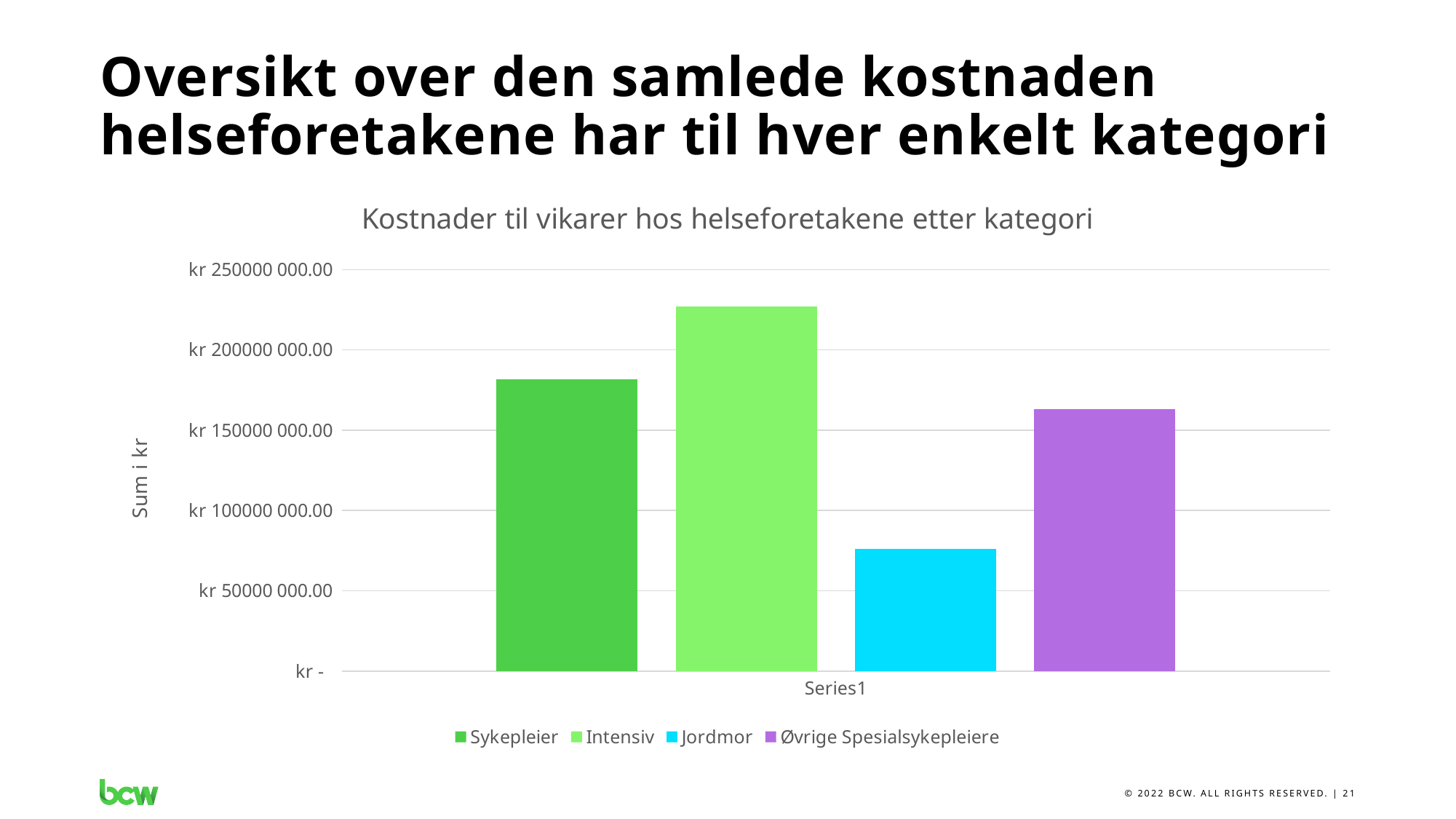
Which is larger, the value for Jordmor or the value for Intensiv? Intensiv What kind of chart is shown on the slide? Bar chart What is the label of the vertical axis? Sum i kr What is the title of the chart? Kostnader til vikarer hos helseforetakene etter kategori Which category has the lowest cost? Jordmor Is the value for Intensiv greater or less than kr 200000 000.00? greater Is the value for Jordmor greater or less than kr 100000 000.00? less Which category has the highest cost? Intensiv Is the value for Sykepleier greater or less than kr 150000 000.00? greater Which is larger, the value for Sykepleier or the value for Øvrige Spesialsykepleiere? Sykepleier How many bars are plotted in the chart? 4 How many series does the legend list? 4